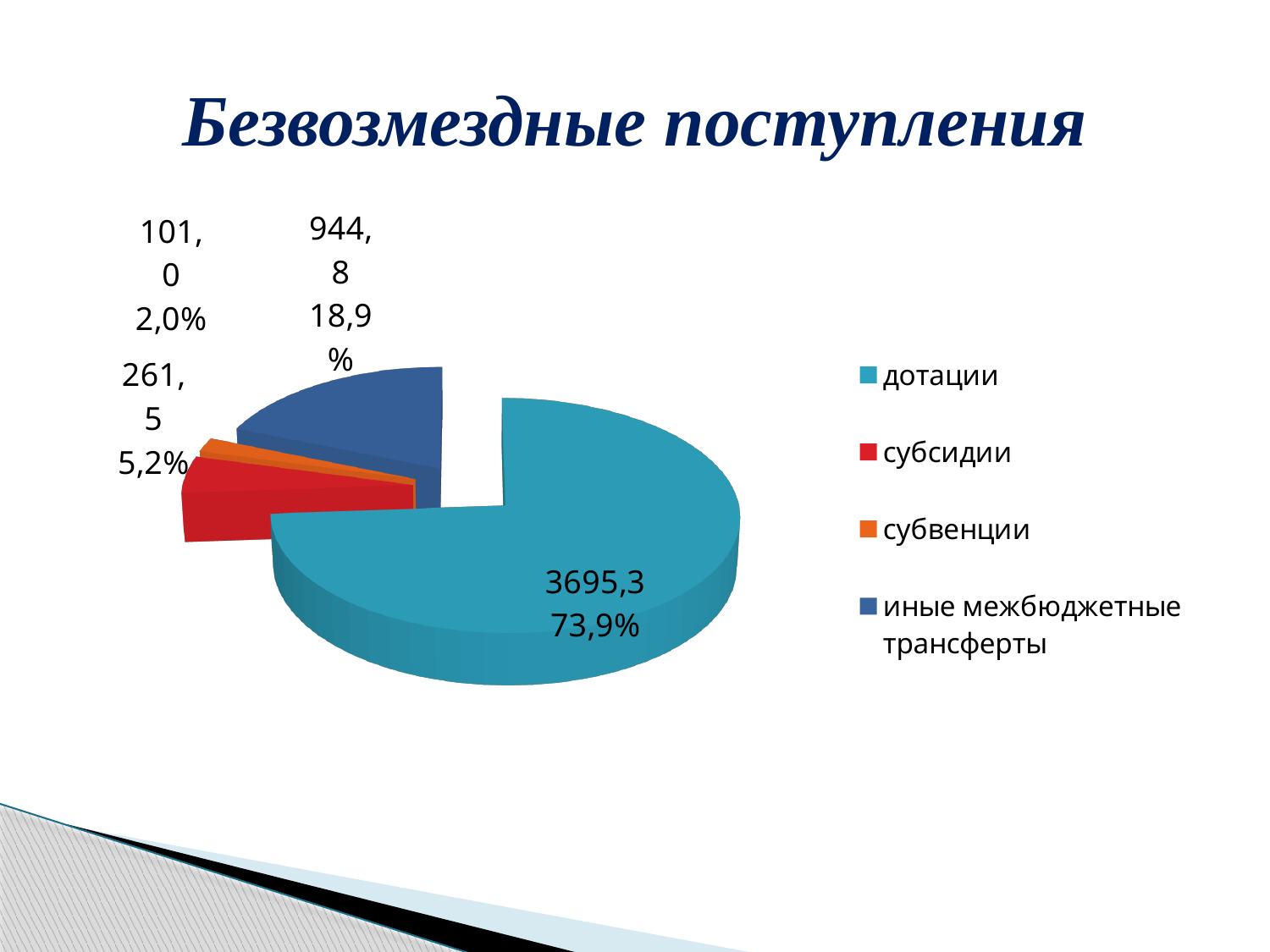
What share of the pie does дотации represent? 73,9% What kind of chart is shown on the slide? pie chart How many slices does the pie chart have? 4 Which category has the smallest slice? субвенции How many categories does the legend list? 4 What is the value shown for иные межбюджетные трансферты? 944,8 What share of the pie does иные межбюджетные трансферты represent? 18,9% What is the title of the chart? Безвозмездные поступления Which category has the largest slice? дотации What share of the pie does субсидии represent? 5,2% Which is larger, the value for субсидии or the value for субвенции? субсидии What is the value shown for дотации? 3695,3